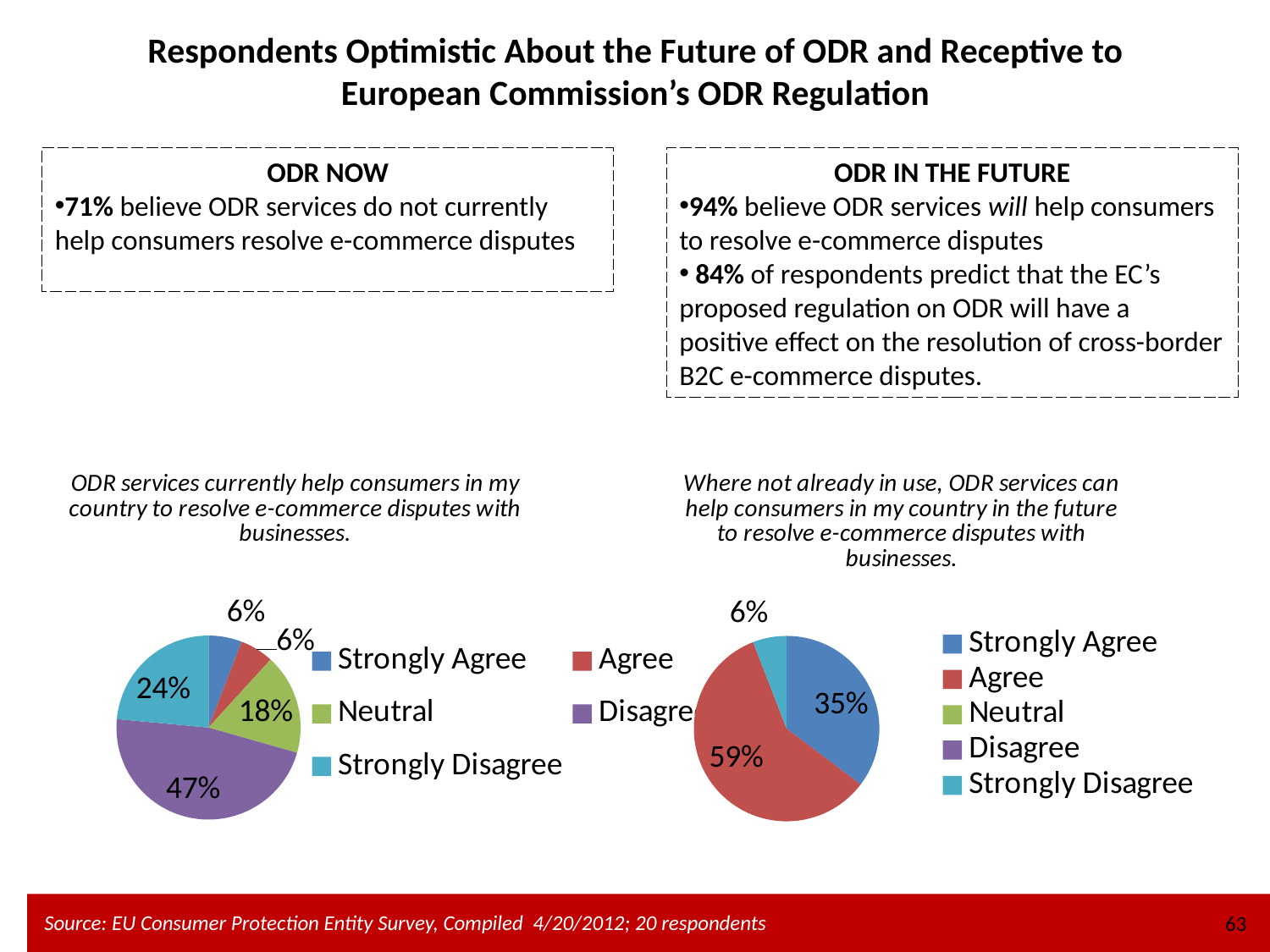
What kind of chart is used on the left side of the slide, titled 'ODR services currently help consumers in my country to resolve e-commerce disputes with businesses'? Pie chart In the right pie chart (ODR services can help consumers in the future), which is larger: the Agree share or the Strongly Agree share? Agree In the left pie chart (ODR services currently help consumers), which response has the largest share? Disagree In the left pie chart (ODR services currently help consumers), what share of respondents chose Strongly Disagree? 24% In the left pie chart (ODR services currently help consumers), what share of respondents chose Disagree? 47% In the right pie chart (ODR services can help consumers in the future), what share of respondents chose Agree? 59% In the right pie chart (ODR services can help consumers in the future), what share of respondents chose Strongly Agree? 35% In the left pie chart (ODR services currently help consumers), what is the difference between the Disagree share and the Strongly Disagree share? 23% In the left pie chart (ODR services currently help consumers), what share of respondents chose Neutral? 18% How many slices are visible in the right pie chart (ODR services can help consumers in the future)? 3 How many entries does the legend of the right pie chart (ODR services can help consumers in the future) list? 5